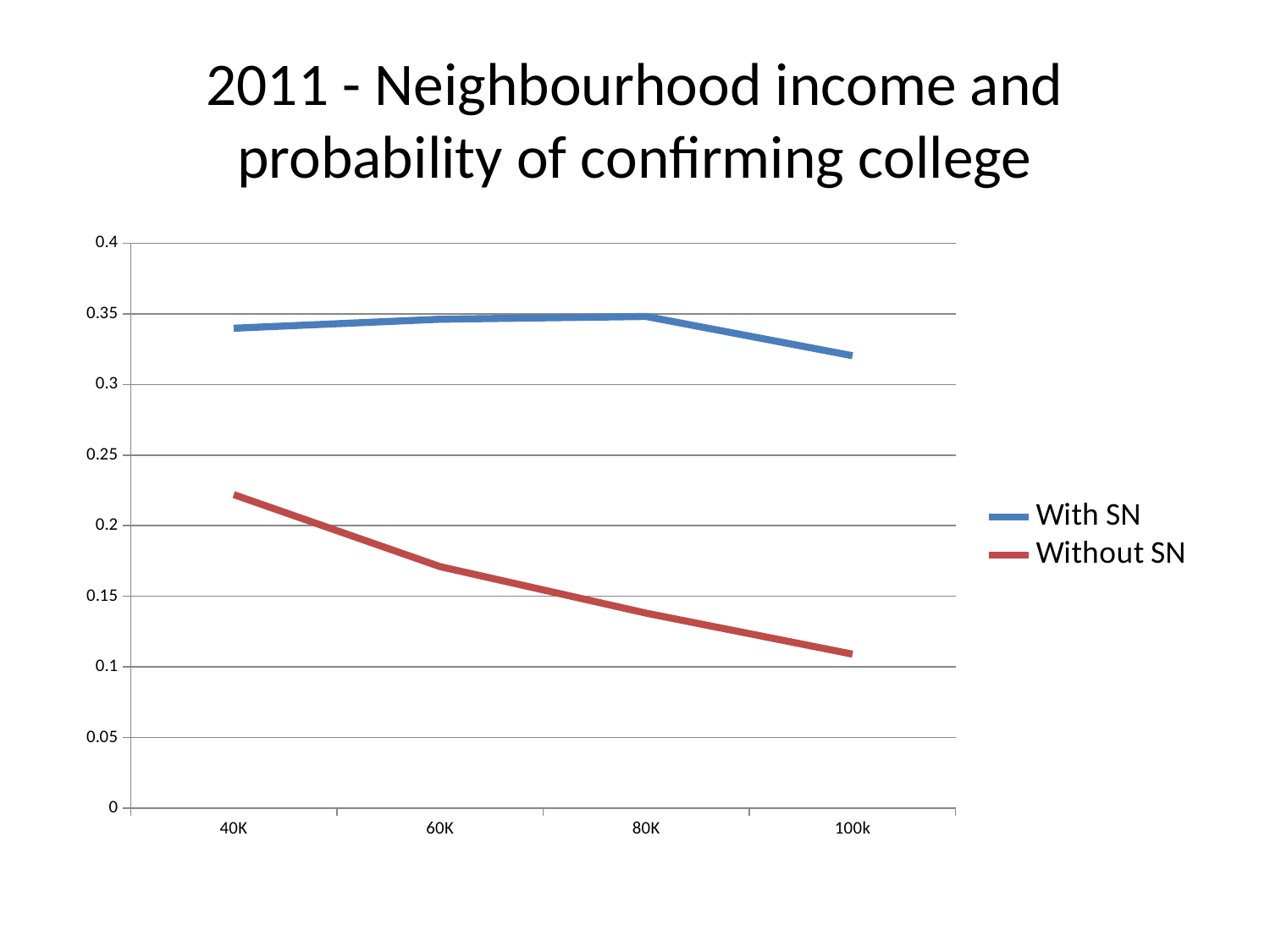
Which colour is used for the Without SN line? red What kind of chart is shown on the slide? line chart Is the With SN value at 100k greater or less than 0.3? greater Is the Without SN value at 100k greater or less than 0.15? less How many income categories are shown on the x axis? 4 At which income level is the Without SN value lowest? 100k Is the Without SN value at 40K greater or less than 0.2? greater Does the Without SN line rise or fall as neighbourhood income increases from 40K to 100k? fall At 40K, which series has the higher value, With SN or Without SN? With SN How many series does the legend list? 2 At which income level is the Without SN value highest? 40K At which income level is the With SN value lowest? 100k